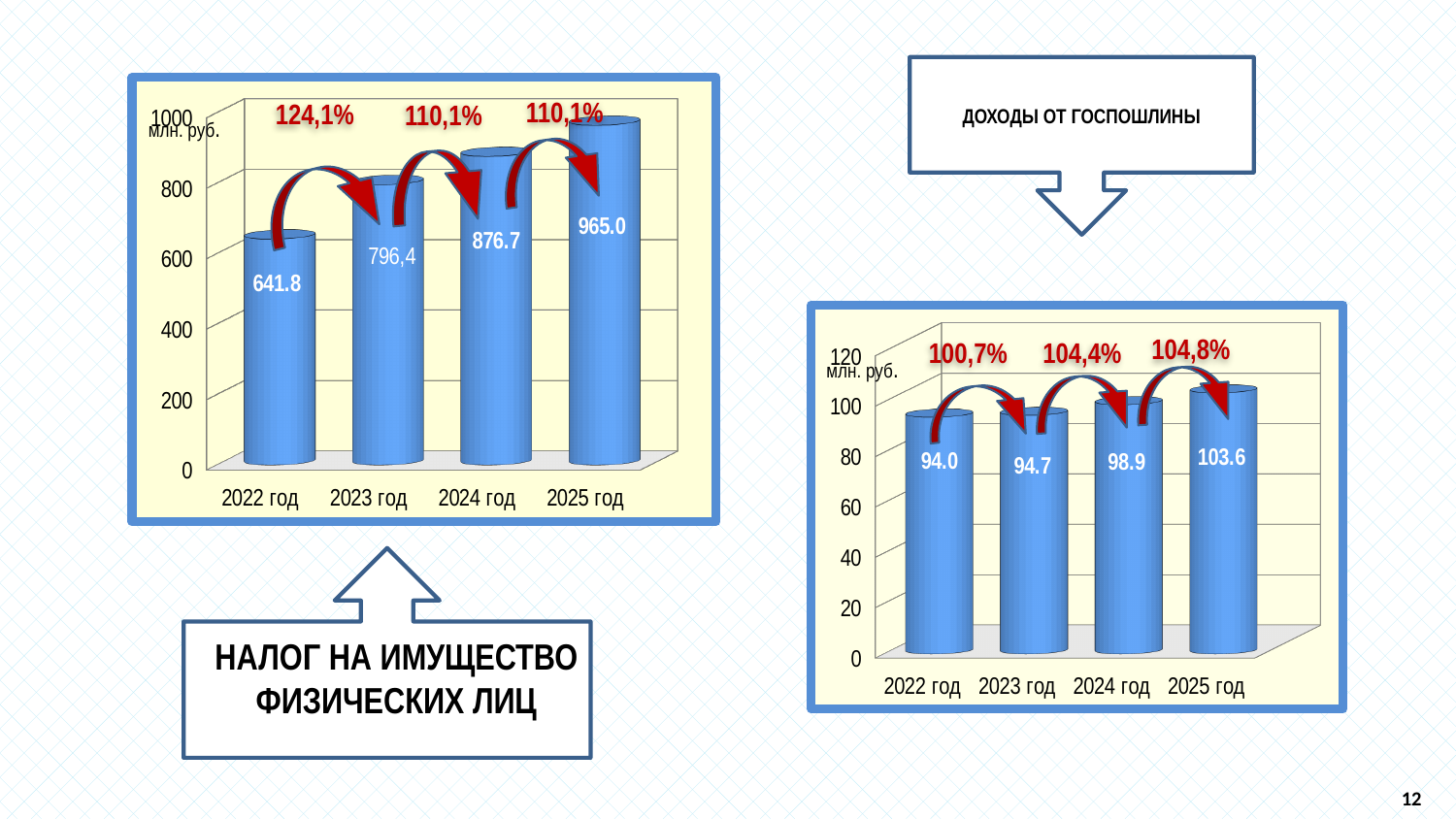
In the chart for НАЛОГ НА ИМУЩЕСТВО ФИЗИЧЕСКИХ ЛИЦ (left), what is the value for 2022 год? 641.8 In the chart for ДОХОДЫ ОТ ГОСПОШЛИНЫ (right), what is the difference between the values for 2025 год and 2022 год? 9.6 In the chart for ДОХОДЫ ОТ ГОСПОШЛИНЫ (right), what is the value for 2024 год? 98.9 In the chart for ДОХОДЫ ОТ ГОСПОШЛИНЫ (right), which year has the lowest value? 2022 год In the chart for НАЛОГ НА ИМУЩЕСТВО ФИЗИЧЕСКИХ ЛИЦ (left), what growth percentage is shown between 2022 год and 2023 год? 124,1% In the chart for НАЛОГ НА ИМУЩЕСТВО ФИЗИЧЕСКИХ ЛИЦ (left), which year has the highest value? 2025 год In the chart for ДОХОДЫ ОТ ГОСПОШЛИНЫ (right), which is larger, the value for 2025 год or the value for 2022 год? 2025 год What kind of chart is the chart for ДОХОДЫ ОТ ГОСПОШЛИНЫ (right)? bar chart In the chart for ДОХОДЫ ОТ ГОСПОШЛИНЫ (right), how many years are shown on the x axis? 4 In the chart for НАЛОГ НА ИМУЩЕСТВО ФИЗИЧЕСКИХ ЛИЦ (left), do the values rise or fall from 2022 год to 2025 год? rise In the chart for НАЛОГ НА ИМУЩЕСТВО ФИЗИЧЕСКИХ ЛИЦ (left), what is the value for 2025 год? 965.0 In the chart for НАЛОГ НА ИМУЩЕСТВО ФИЗИЧЕСКИХ ЛИЦ (left), what is the difference between the values for 2025 год and 2022 год? 323.2